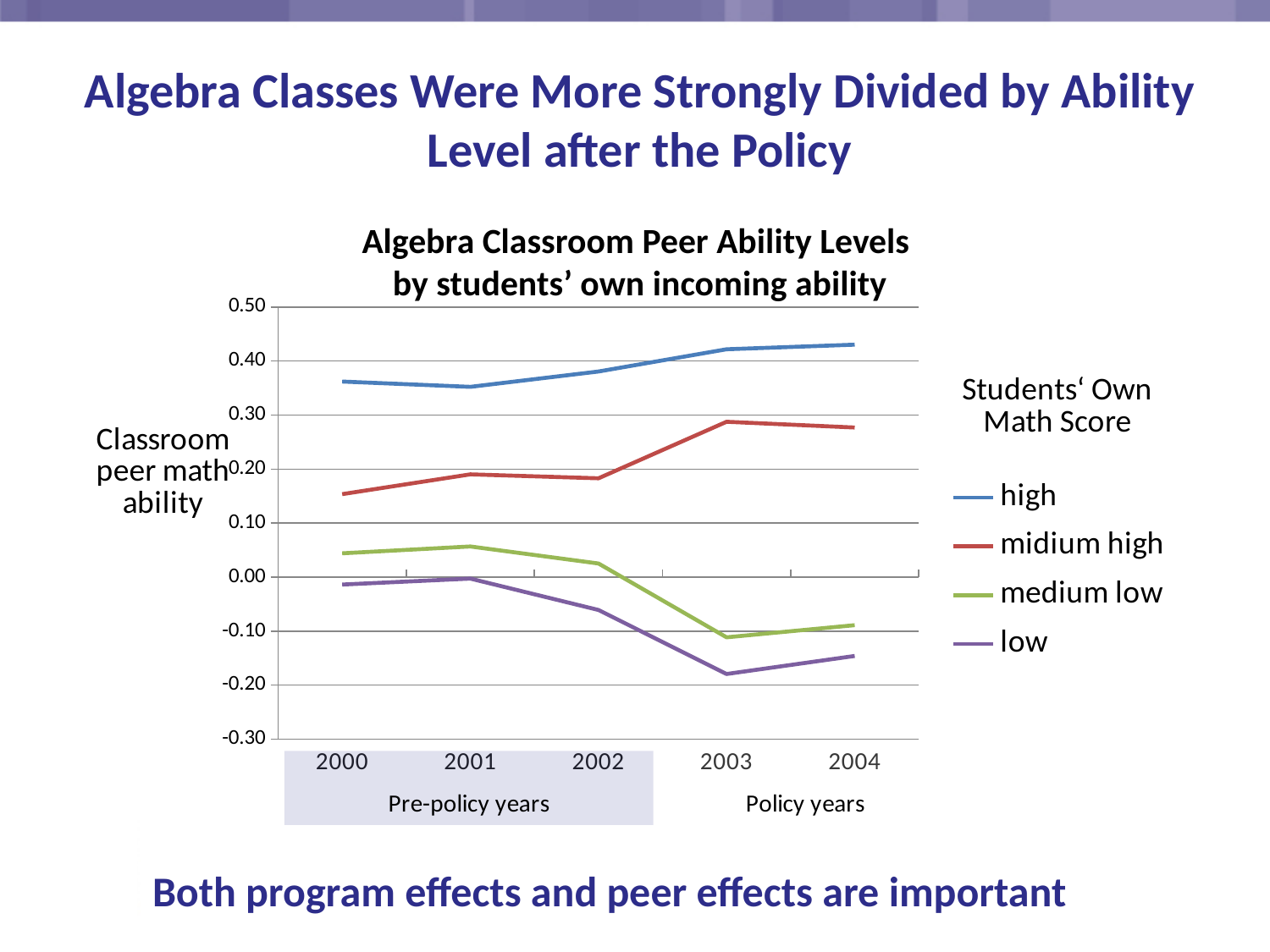
What is the title of the chart? Algebra Classroom Peer Ability Levels by students' own incoming ability In 2002, which is larger: the medium low series or the low series? medium low How many series does the legend list? 4 Is the value for the midium high series in 2000 greater or less than 0.10? greater What kind of chart is shown on the slide? line chart Does the low series rise or fall overall from 2000 to 2004? fall Which series has the highest value in 2004? high Is the value for the low series in 2003 greater or less than -0.10? less Which series has the lowest value in 2003? low Is the value for the medium low series in 2003 greater or less than 0.00? less How many years are shown on the x axis? 5